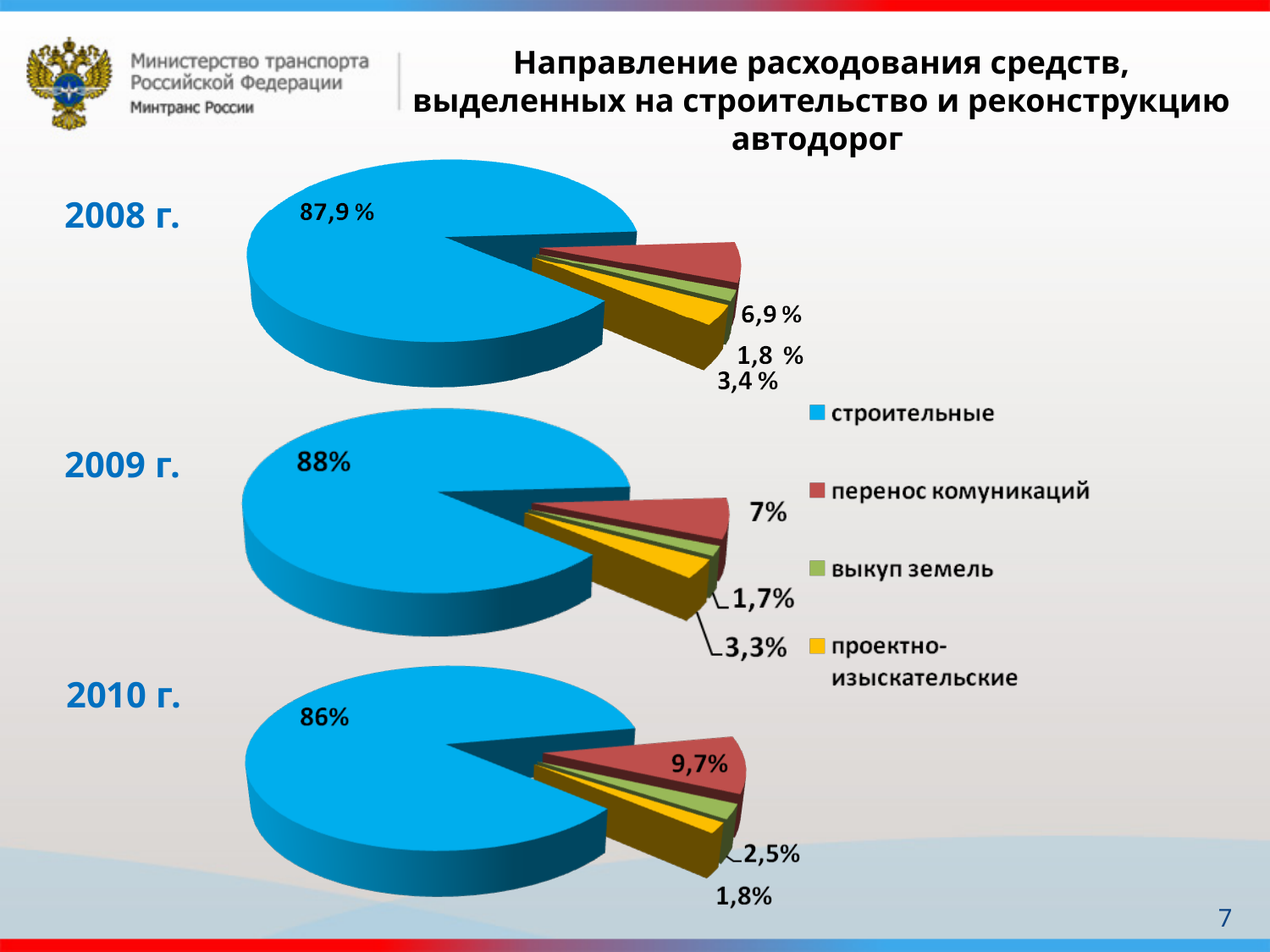
In the 2009 pie chart, what share is shown for проектно-изыскательские? 3,3% What is the difference between the перенос комуникаций share in 2010 and in 2009? 2,7% What type of chart is used for each year on the slide? Pie chart In the 2008 pie chart, what share is labelled for the строительные slice? 87,9 % In the 2010 pie chart, what share is shown for строительные? 86% In the 2010 pie chart, what share is shown for перенос комуникаций? 9,7% In the 2008 pie chart, which category has the smallest share? выкуп земель Which is larger in the 2008 pie chart: the share for проектно-изыскательские or for выкуп земель? проектно-изыскательские In the 2008 pie chart, what share is shown for перенос комуникаций? 6,9 % In the 2009 pie chart, what share is shown for выкуп земель? 1,7% In the 2009 pie chart, which category has the largest share? строительные How many categories does the legend list for the pie charts? 4